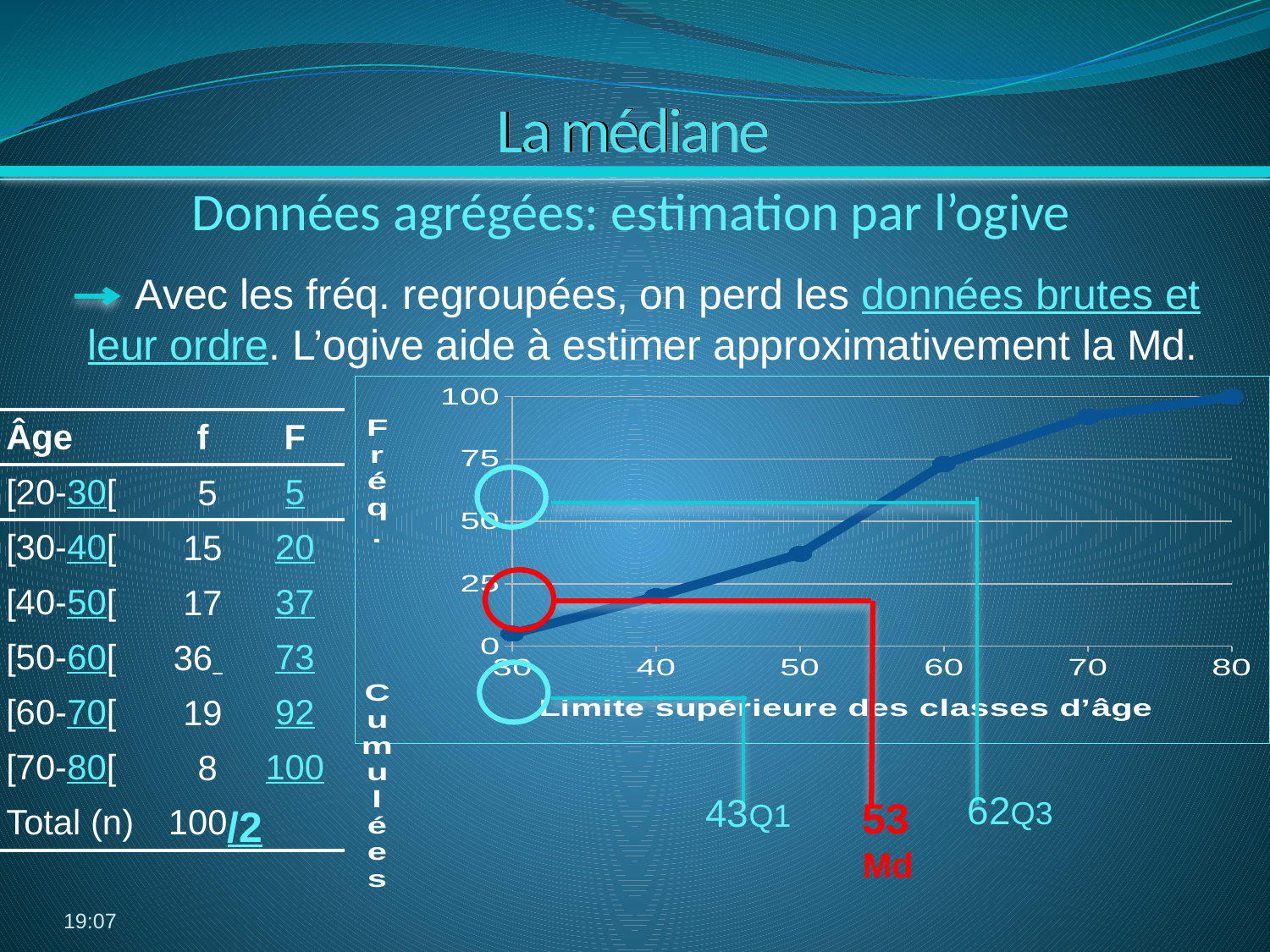
Is the cumulative frequency at the upper class limit of 40 greater or less than 25? less What is the cumulative frequency plotted at the upper class limit of 80? 100 At which upper class limit is the cumulative frequency lowest? 30 Is the cumulative frequency at the upper class limit of 50 greater or less than 50? less Which has the larger cumulative frequency: the upper class limit of 50 or the upper class limit of 60? 60 What is the title of the x axis of the chart? Limite supérieure des classes d'âge Is the cumulative frequency at the upper class limit of 70 greater or less than 75? greater What value is marked as the median (Md) below the chart? 53 How many data points are plotted on the ogive? 6 Do the cumulative frequency values rise or fall as the upper class limit increases from 30 to 80? rise What kind of chart is shown on the slide? line chart At which upper class limit is the cumulative frequency highest? 80